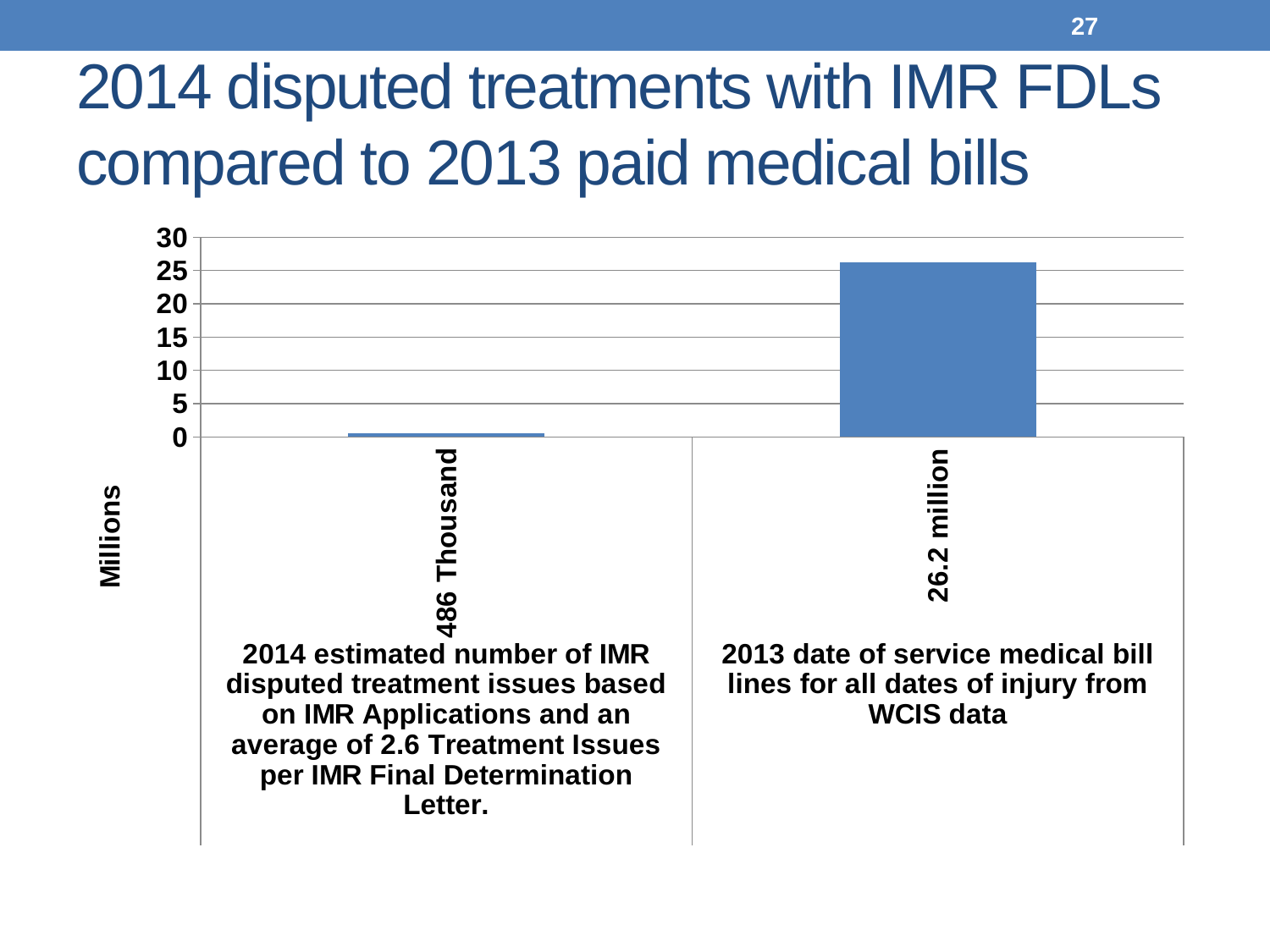
What is the highest tick value shown on the vertical axis? 30 Which category has the taller bar? 2013 date of service medical bill lines for all dates of injury from WCIS data What kind of chart is shown on the slide? bar chart Is the value for 2013 date of service medical bill lines greater or less than 30 on the axis? less Is the value for 2013 date of service medical bill lines greater or less than 25 on the axis? greater What is the label on the vertical axis of the chart? Millions Is the value for the 2014 estimated IMR disputed treatment issues greater or less than 5 on the axis? less What is the data label on the bar for 2013 date of service medical bill lines from WCIS data? 26.2 million Is the bar for 2013 medical bill lines larger or smaller than the bar for 2014 IMR disputed treatment issues? larger Which category has the shorter bar? 2014 estimated number of IMR disputed treatment issues What is the data label on the bar for the 2014 estimated number of IMR disputed treatment issues? 486 Thousand How many bars are plotted in the chart? 2